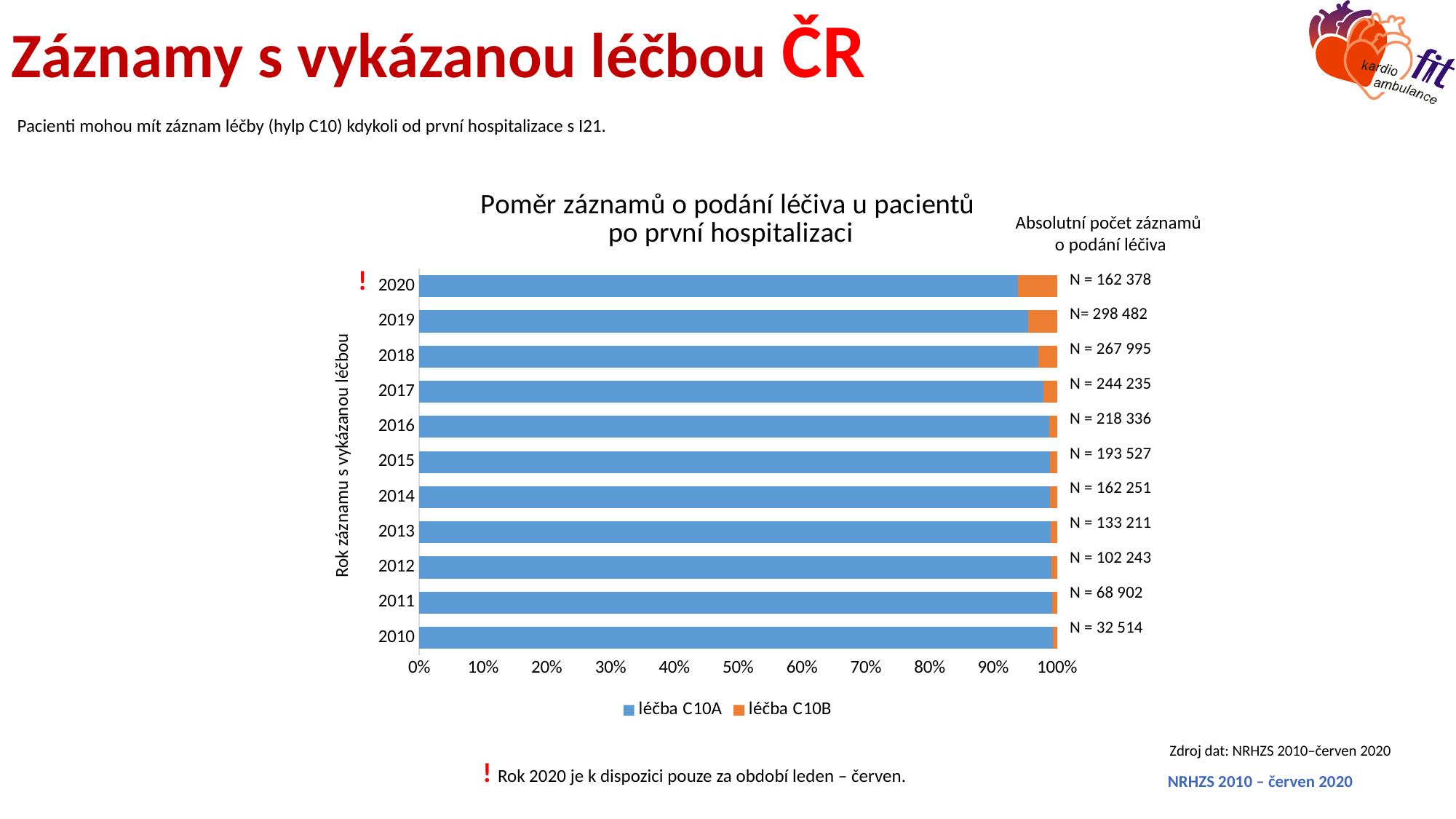
What is the absolute number of records (N) shown for 2020? N = 162 378 Which year has a larger N value, 2017 or 2016? 2017 Does the absolute number of records (N) rise or fall from 2010 to 2019? rise Which year has the lowest absolute number of records (N)? 2010 What are the two series named in the chart legend? léčba C10A and léčba C10B How many years are plotted on the y axis of the chart? 11 What is the absolute number of records (N) shown for 2010? N = 32 514 Is the share of léčba C10A for 2020 greater or less than 90%? greater What kind of chart is shown on the slide? bar chart What is the difference between the N values for 2019 and 2018? 30 487 How many series does the chart legend list? 2 Which year has the highest absolute number of records (N)? 2019